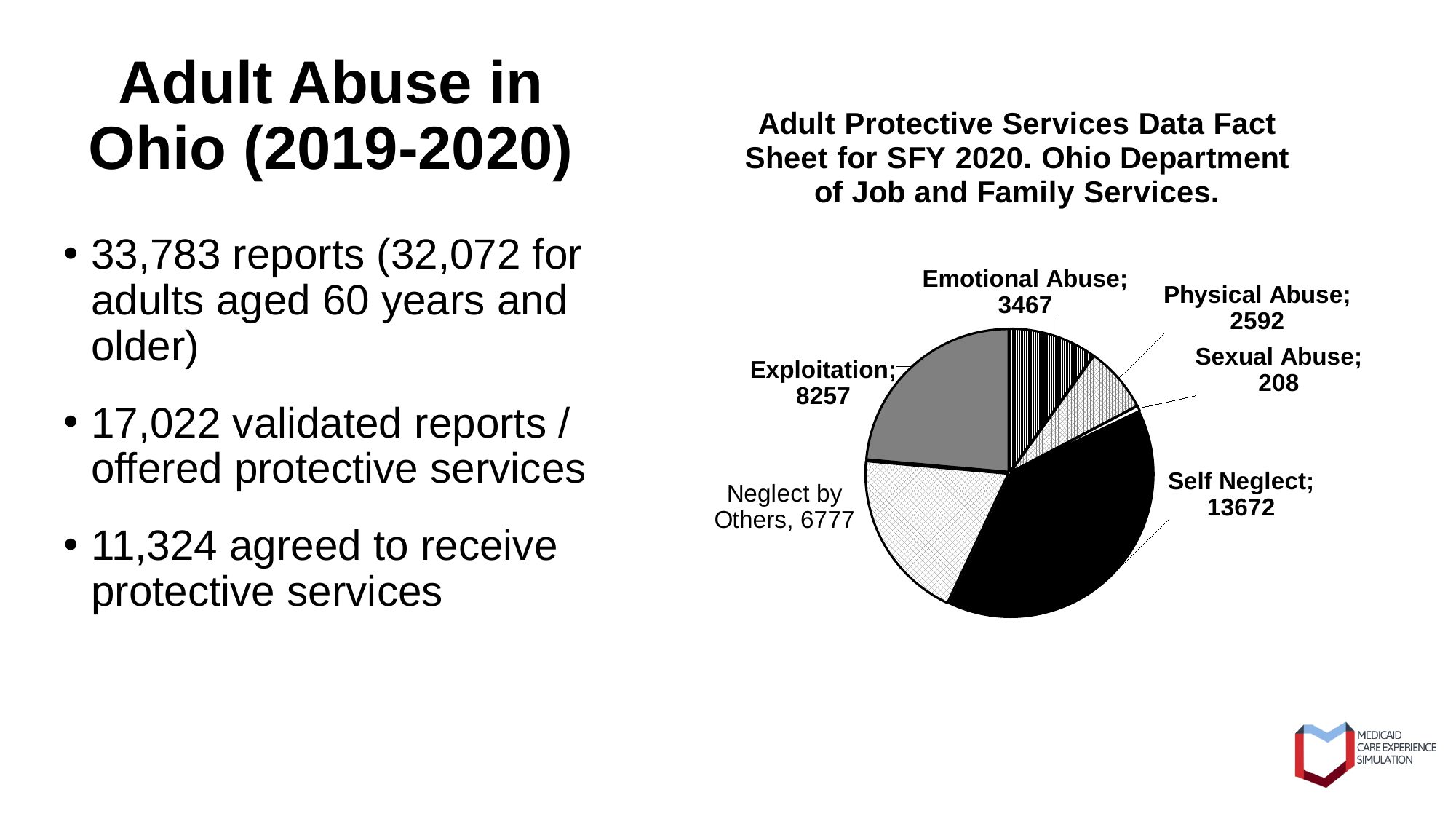
What is the difference between the Self Neglect and Exploitation values? 5415 What is the title of the pie chart? Adult Protective Services Data Fact Sheet for SFY 2020. Ohio Department of Job and Family Services. What is the value for Exploitation in the pie chart? 8257 What is the value for Neglect by Others in the pie chart? 6777 What is the value for Self Neglect in the pie chart? 13672 What is the value for Sexual Abuse in the pie chart? 208 Which is larger, Exploitation or Neglect by Others? Exploitation What type of chart is shown on the slide? pie chart How many categories are shown in the pie chart? 6 Which category has the largest slice in the pie chart? Self Neglect Which category has the smallest slice in the pie chart? Sexual Abuse What is the difference between the Emotional Abuse and Physical Abuse values? 875